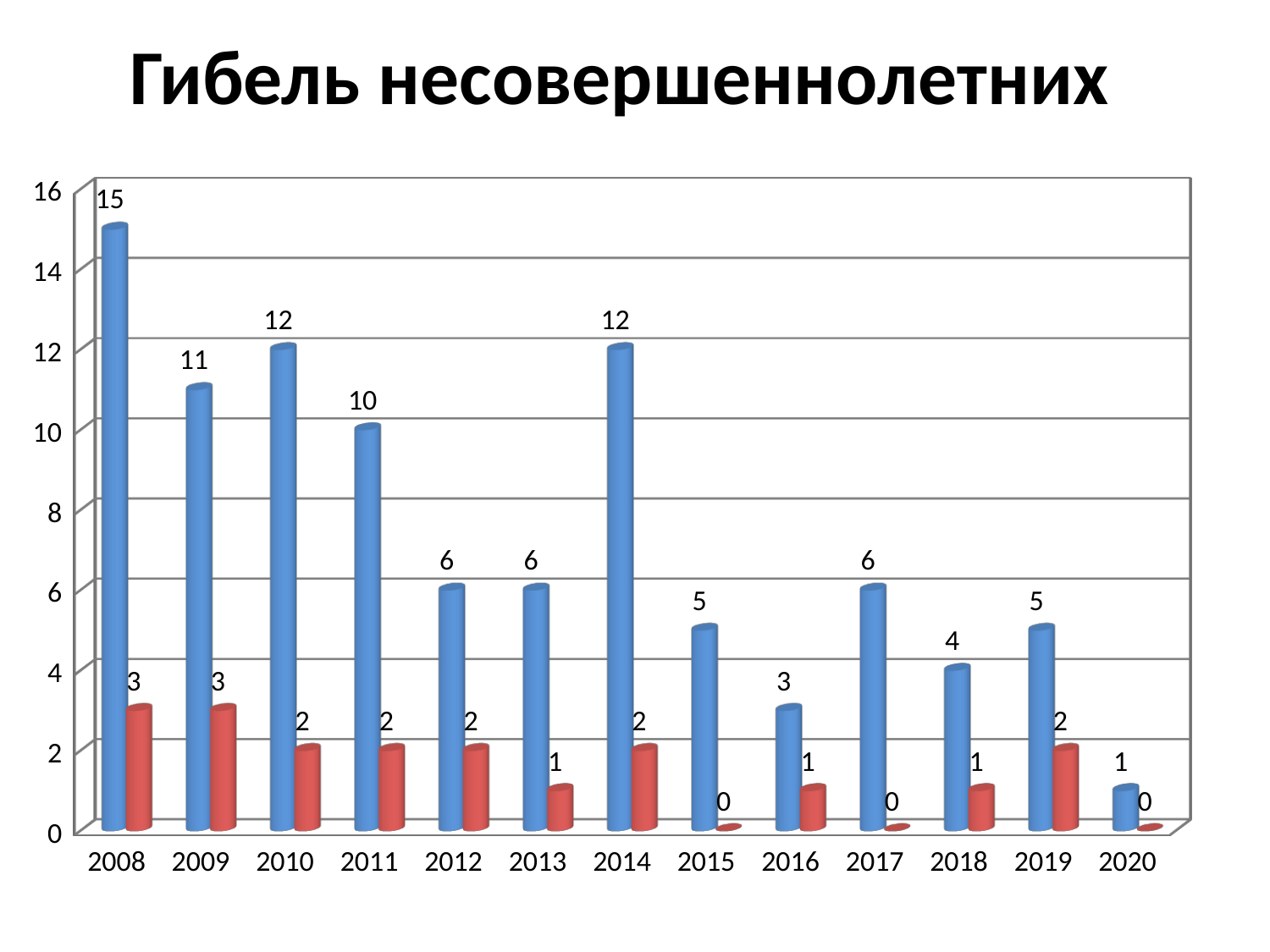
What is the value of the blue bar for 2008? 15 How many data series are plotted in the chart? 2 Do the blue bar values generally rise or fall from 2008 to 2020? Fall What type of chart is shown on the slide? Bar chart Which year has the lowest blue bar? 2020 What is the value of the red bar for 2019? 2 Which year has the highest blue bar? 2008 What is the title of the chart? Гибель несовершеннолетних How many years are shown on the x axis? 13 Which is larger, the blue bar for 2011 or the blue bar for 2014? 2014 What is the difference between the blue bar values for 2008 and 2009? 4 What is the value of the blue bar for 2017? 6